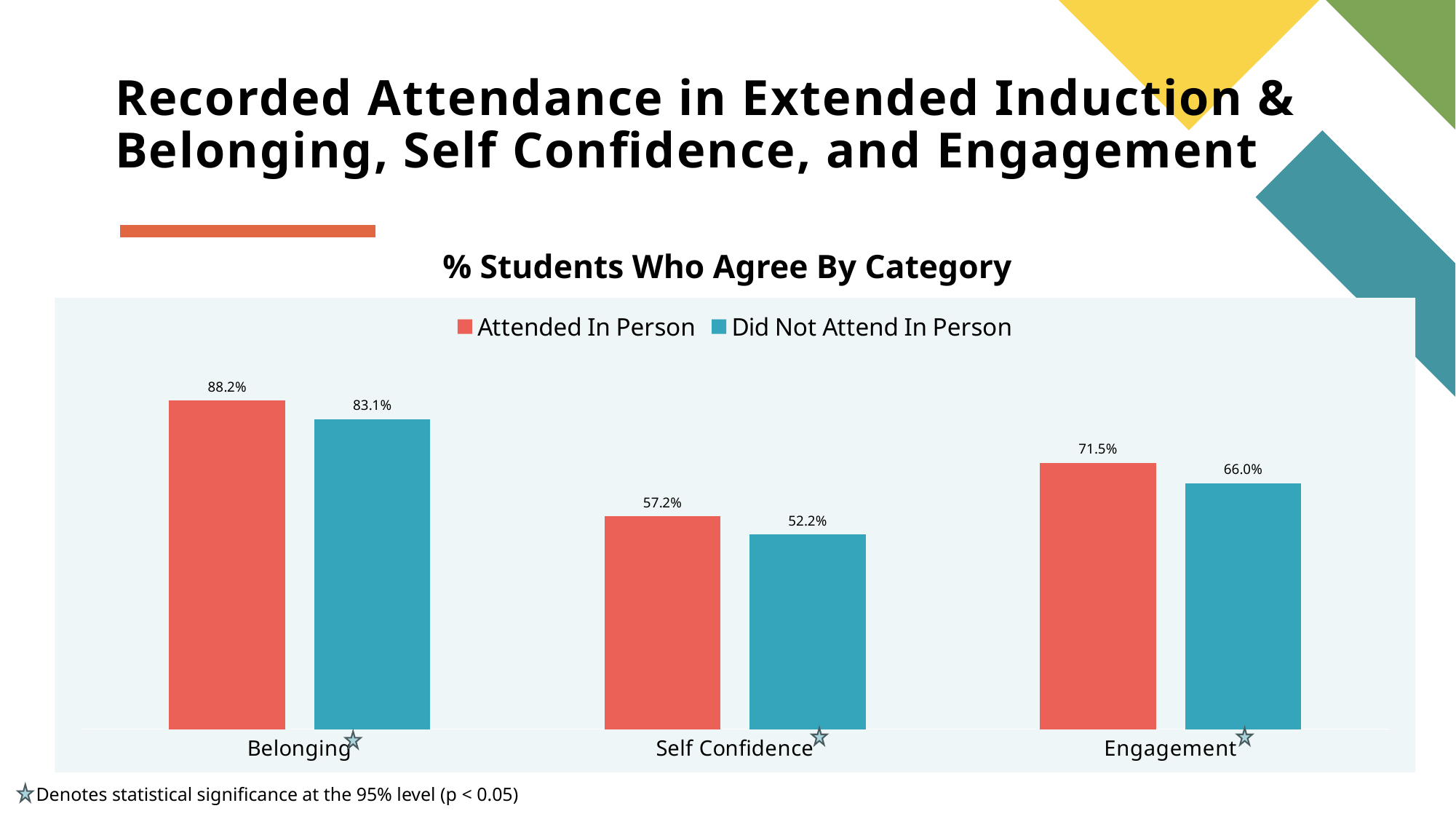
What is the value for Did Not Attend In Person in the Engagement category? 66.0% In the Self Confidence category, which series has the larger value: Attended In Person or Did Not Attend In Person? Attended In Person What is the title of the chart? % Students Who Agree By Category How many categories are shown on the x axis? 3 Which category has the lowest value for Did Not Attend In Person? Self Confidence What is the difference between Attended In Person and Did Not Attend In Person in the Belonging category? 5.1% What percentage of students who attended in person agree in the Belonging category? 88.2% Which category has the highest value for Attended In Person? Belonging What kind of chart is shown on the slide? Bar chart How many series does the legend list? 2 What is the difference between Attended In Person and Did Not Attend In Person in the Engagement category? 5.5% What percentage of students who did not attend in person agree in the Self Confidence category? 52.2%